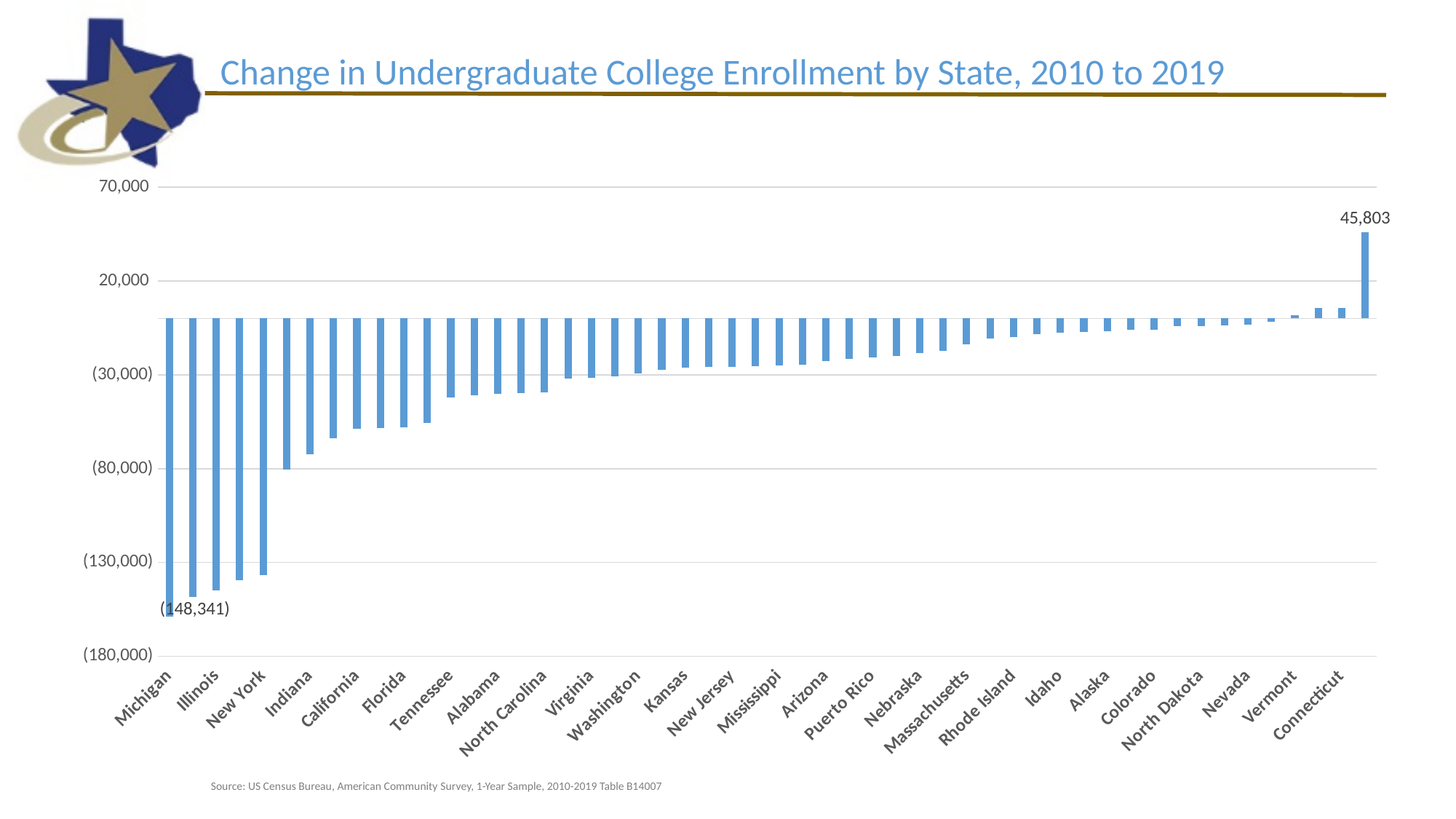
Do the values rise or fall moving from left to right along the x axis? Rise What colour are the bars in the chart? Blue Is the value for California greater or less than (30,000)? less What kind of chart is shown on the slide? Bar chart Which state has the lowest change in undergraduate enrollment? Michigan Is the value for Nebraska greater or less than (30,000)? greater What is the title of the chart? Change in Undergraduate College Enrollment by State, 2010 to 2019 Which has the larger value, Indiana or Florida? Florida